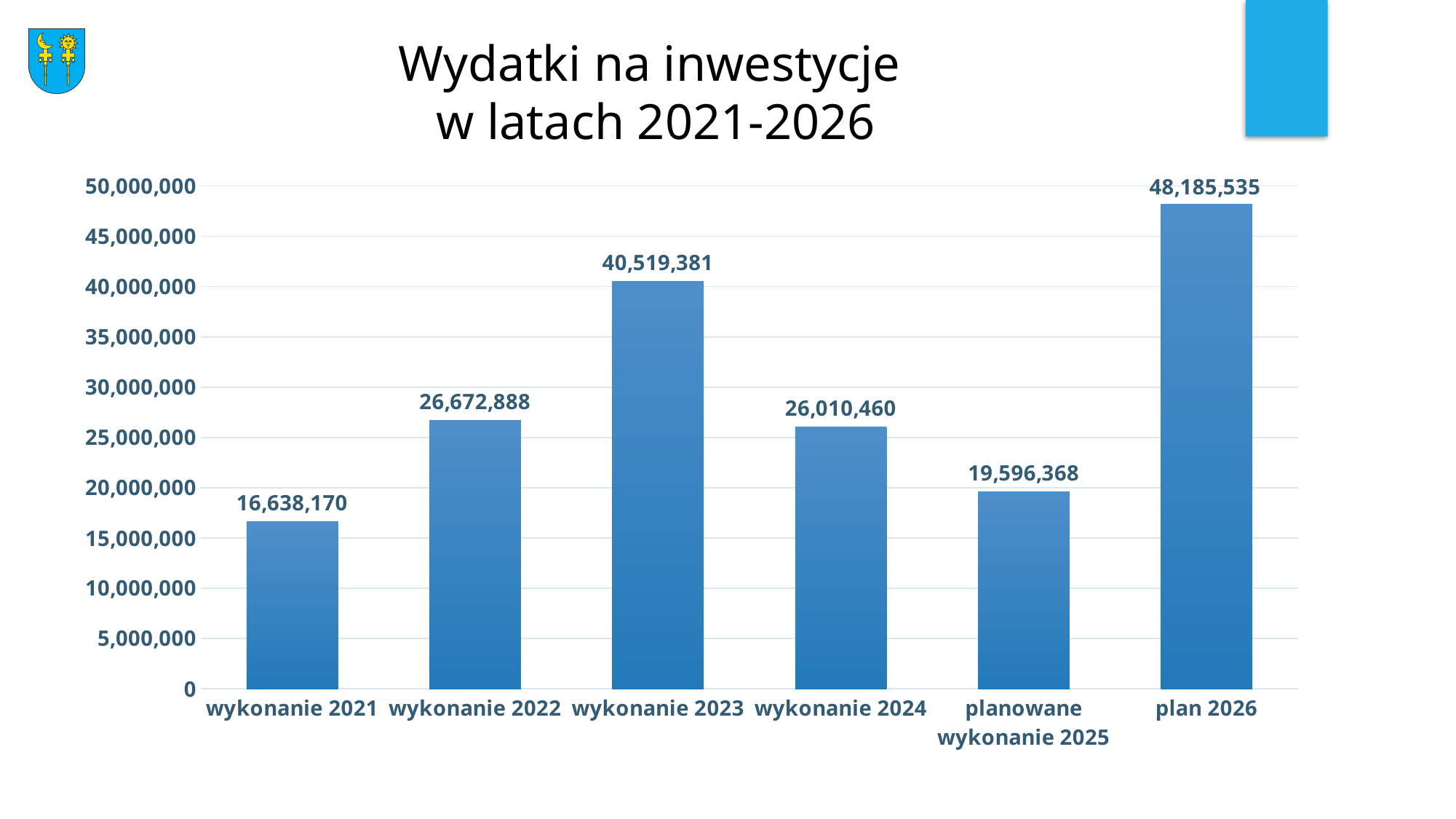
What is the title of the chart? Wydatki na inwestycje w latach 2021-2026 What is the difference between the value for plan 2026 and the value for wykonanie 2021? 31,547,365 What kind of chart is shown on the slide? bar chart What is the value for planowane wykonanie 2025? 19,596,368 What is the value for wykonanie 2023? 40,519,381 Which category has the lowest value? wykonanie 2021 Which is larger, the value for wykonanie 2022 or the value for wykonanie 2024? wykonanie 2022 What is the value for wykonanie 2021? 16,638,170 Which category has the highest value? plan 2026 Is the value for wykonanie 2023 greater or less than 35,000,000? greater What is the difference between the value for wykonanie 2022 and the value for wykonanie 2024? 662,428 How many categories are shown on the x axis? 6